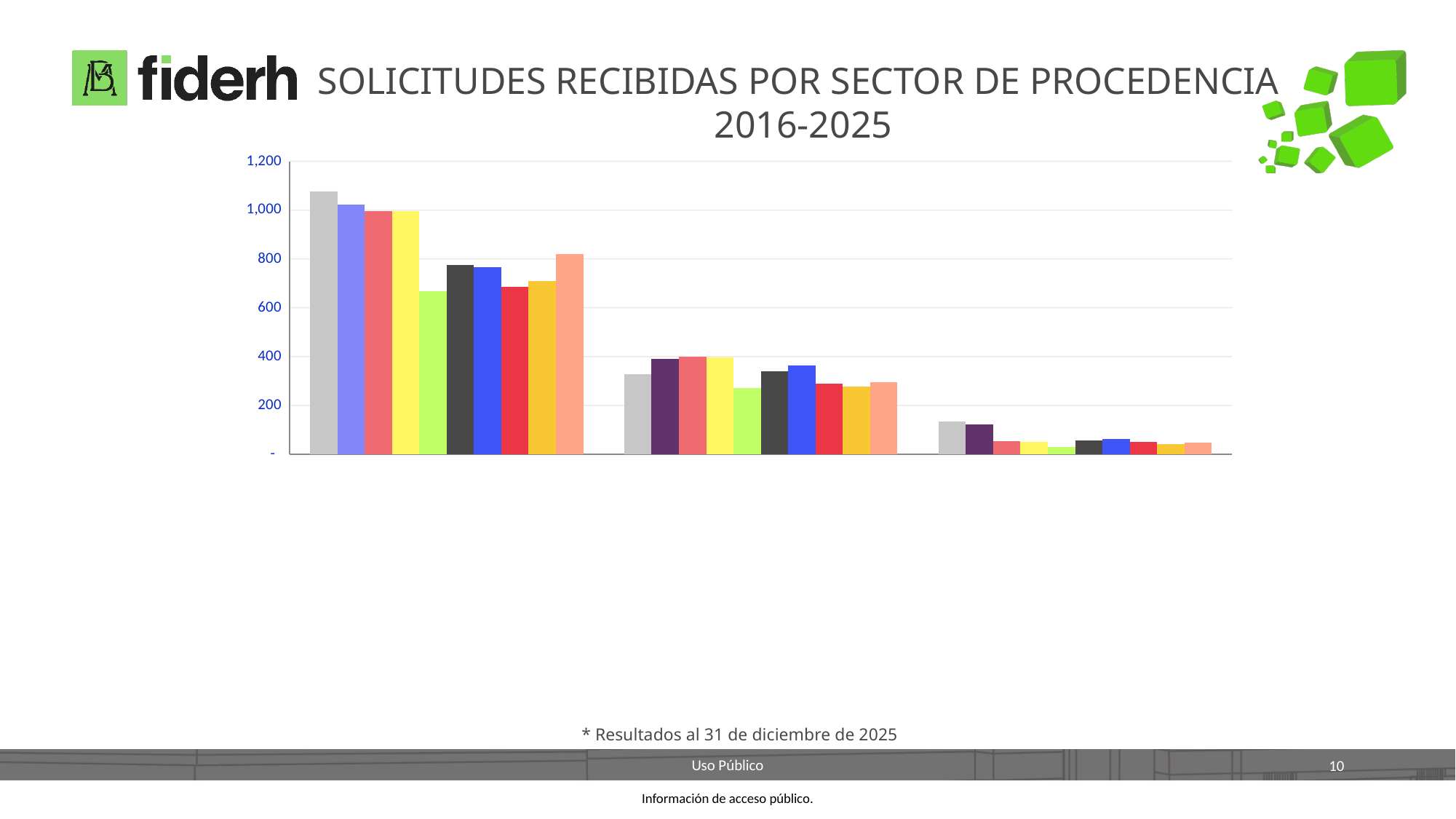
Is the value of the leftmost bar in the middle group greater or less than 400? less What is the title of the chart on the slide? SOLICITUDES RECIBIDAS POR SECTOR DE PROCEDENCIA 2016-2025 Is the value of the tallest bar in the rightmost group greater or less than 200? less Is the value of the leftmost bar in the first (leftmost) group greater or less than 1,000? greater How many bars are in each group of the chart? 10 What is the highest value shown on the vertical axis? 1,200 Which group of bars contains the tallest bar in the chart? The first (leftmost) group How many groups of bars does the chart show? 3 What kind of chart is shown on the slide? Bar chart